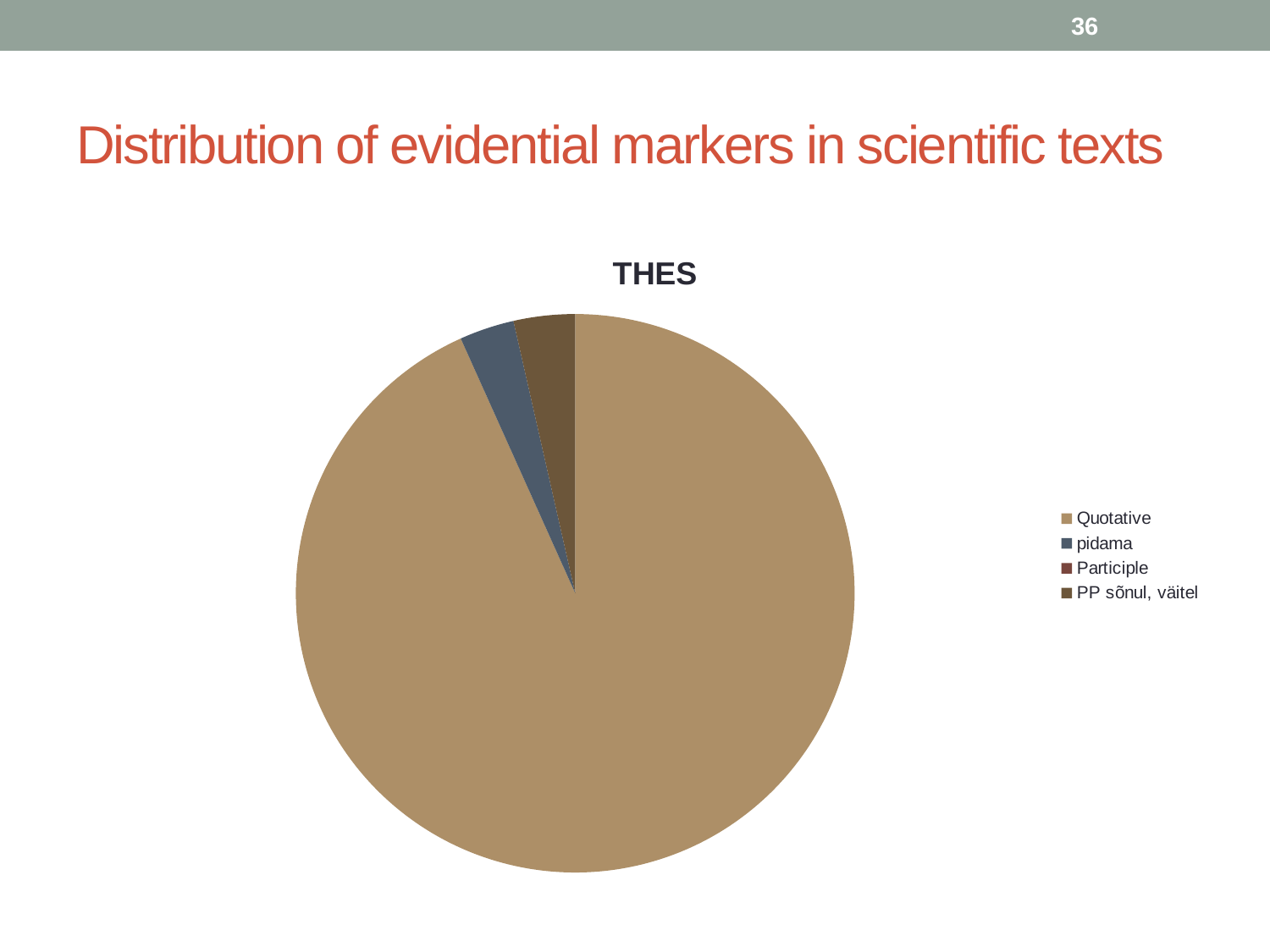
Which is larger, the slice for Quotative or the slice for PP sõnul, väitel? Quotative What kind of chart is shown on the slide? pie chart Does the Quotative slice take up more or less than half of the pie? more Which category has the largest slice of the pie? Quotative How many entries does the legend list? 4 Which is larger, the slice for Quotative or the slice for pidama? Quotative Which legend entry is listed first? Quotative What is the title of the pie chart? THES